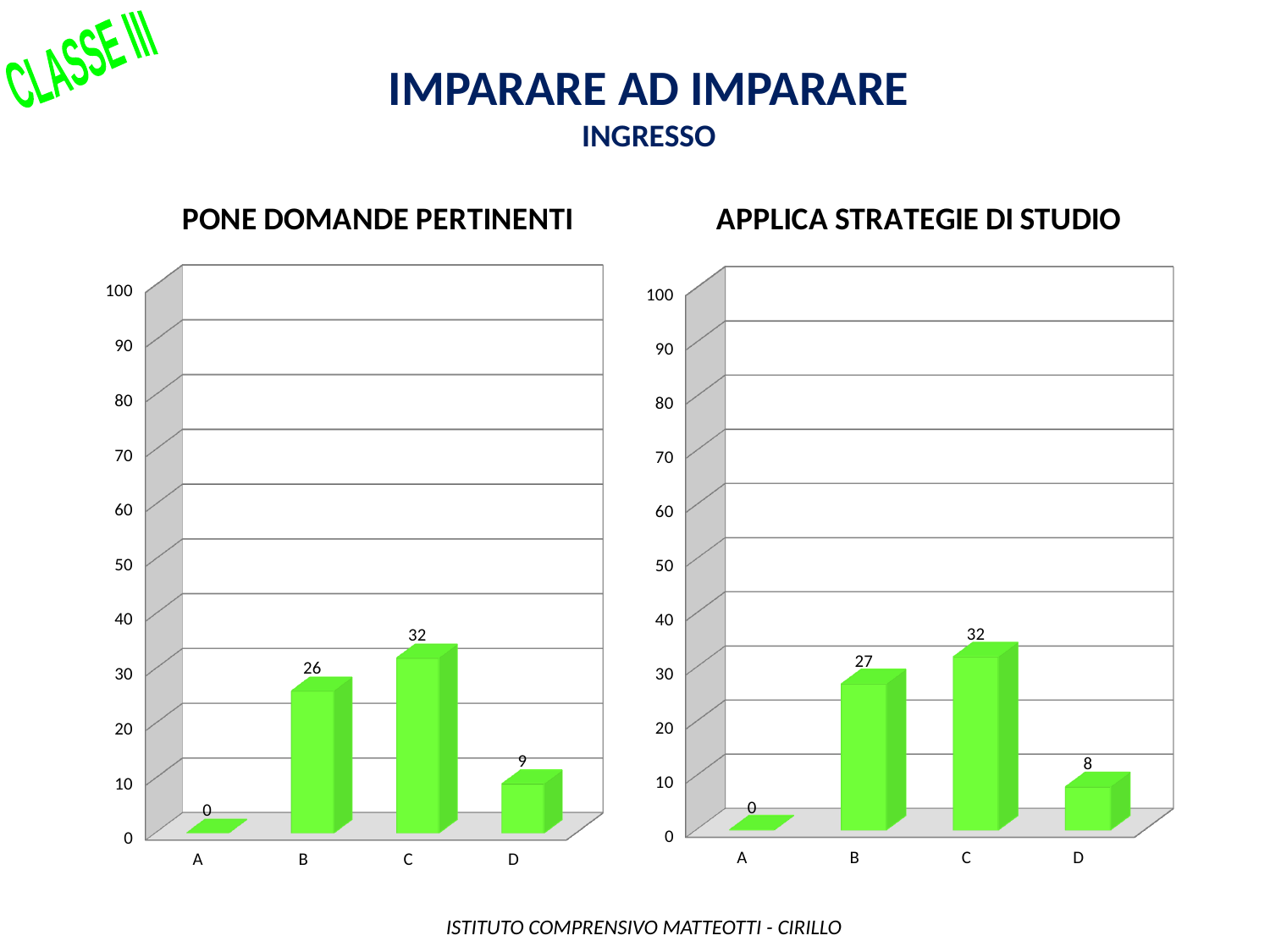
In the 'PONE DOMANDE PERTINENTI' chart, what is the difference between the values for C and B? 6 In the 'PONE DOMANDE PERTINENTI' chart, which category has the highest value? C In the 'PONE DOMANDE PERTINENTI' chart, what is the value for category A? 0 In the 'APPLICA STRATEGIE DI STUDIO' chart, which is larger, the value for B or the value for C? C In the 'APPLICA STRATEGIE DI STUDIO' chart, what is the difference between the values for B and D? 19 In the 'APPLICA STRATEGIE DI STUDIO' chart, what is the value for category D? 8 In the 'APPLICA STRATEGIE DI STUDIO' chart, which category has the lowest value? A In the 'PONE DOMANDE PERTINENTI' chart, is the value for D greater or less than 20? less What kind of chart is 'APPLICA STRATEGIE DI STUDIO'? bar chart What is the title of the chart on the right side of the slide? APPLICA STRATEGIE DI STUDIO How many categories are shown on the x axis of the 'PONE DOMANDE PERTINENTI' chart? 4 In the 'PONE DOMANDE PERTINENTI' chart, what is the value for category B? 26